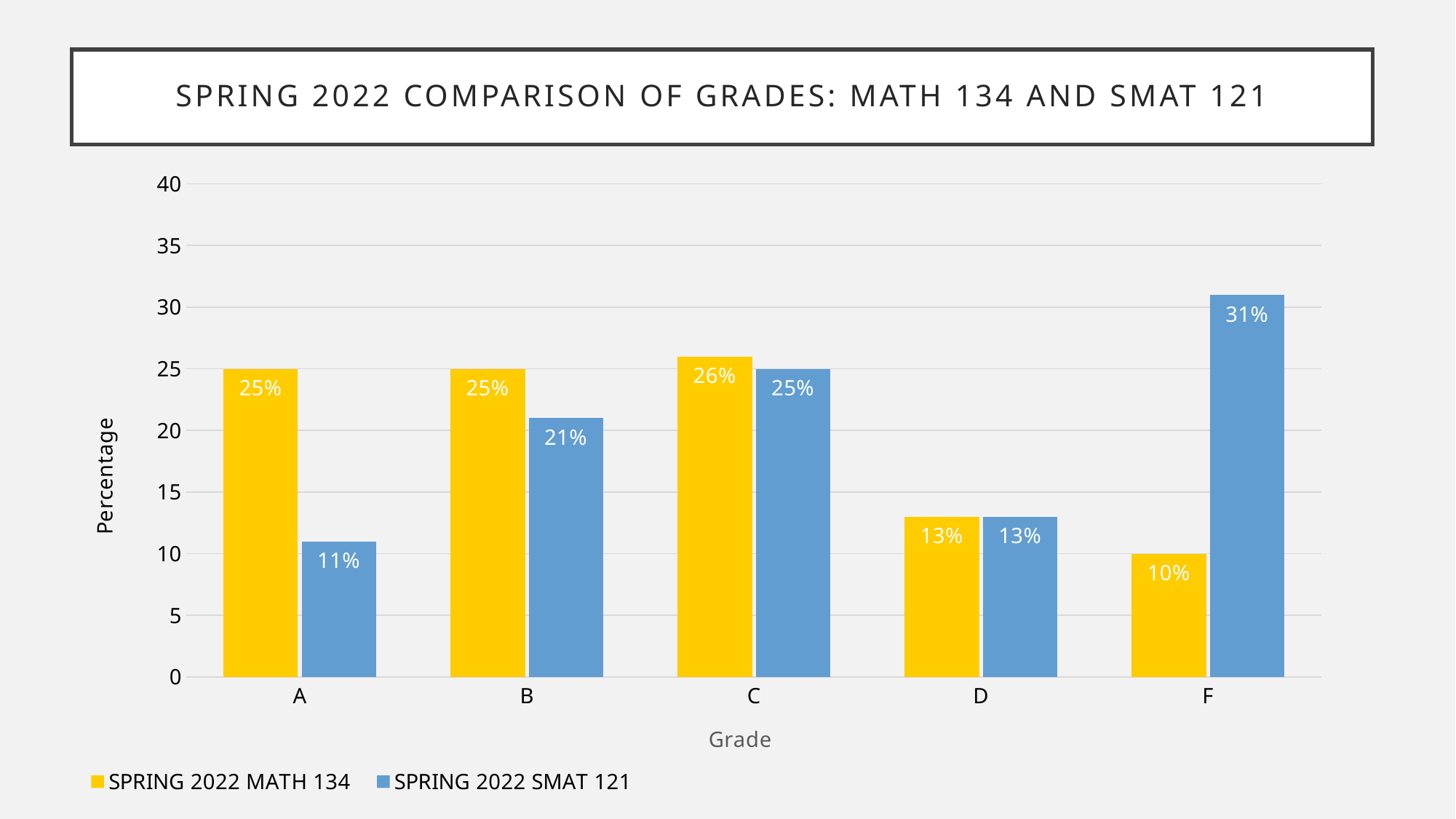
What kind of chart is shown on the slide? Bar chart What is the difference between the SPRING 2022 MATH 134 and SPRING 2022 SMAT 121 percentages for grade A? 14% What is the label on the vertical axis? Percentage What percentage of SPRING 2022 MATH 134 students received a grade of A? 25% Which grade has the highest percentage for SPRING 2022 SMAT 121? F How many series does the legend list? 2 For grade F, which series has the larger percentage, SPRING 2022 MATH 134 or SPRING 2022 SMAT 121? SPRING 2022 SMAT 121 Which grade has the lowest percentage for SPRING 2022 MATH 134? F How many grade categories are shown on the x axis? 5 What is the value for grade B in the SPRING 2022 SMAT 121 series? 21% What percentage of SPRING 2022 SMAT 121 students received a grade of F? 31% What is the title of the chart? SPRING 2022 COMPARISON OF GRADES: MATH 134 AND SMAT 121